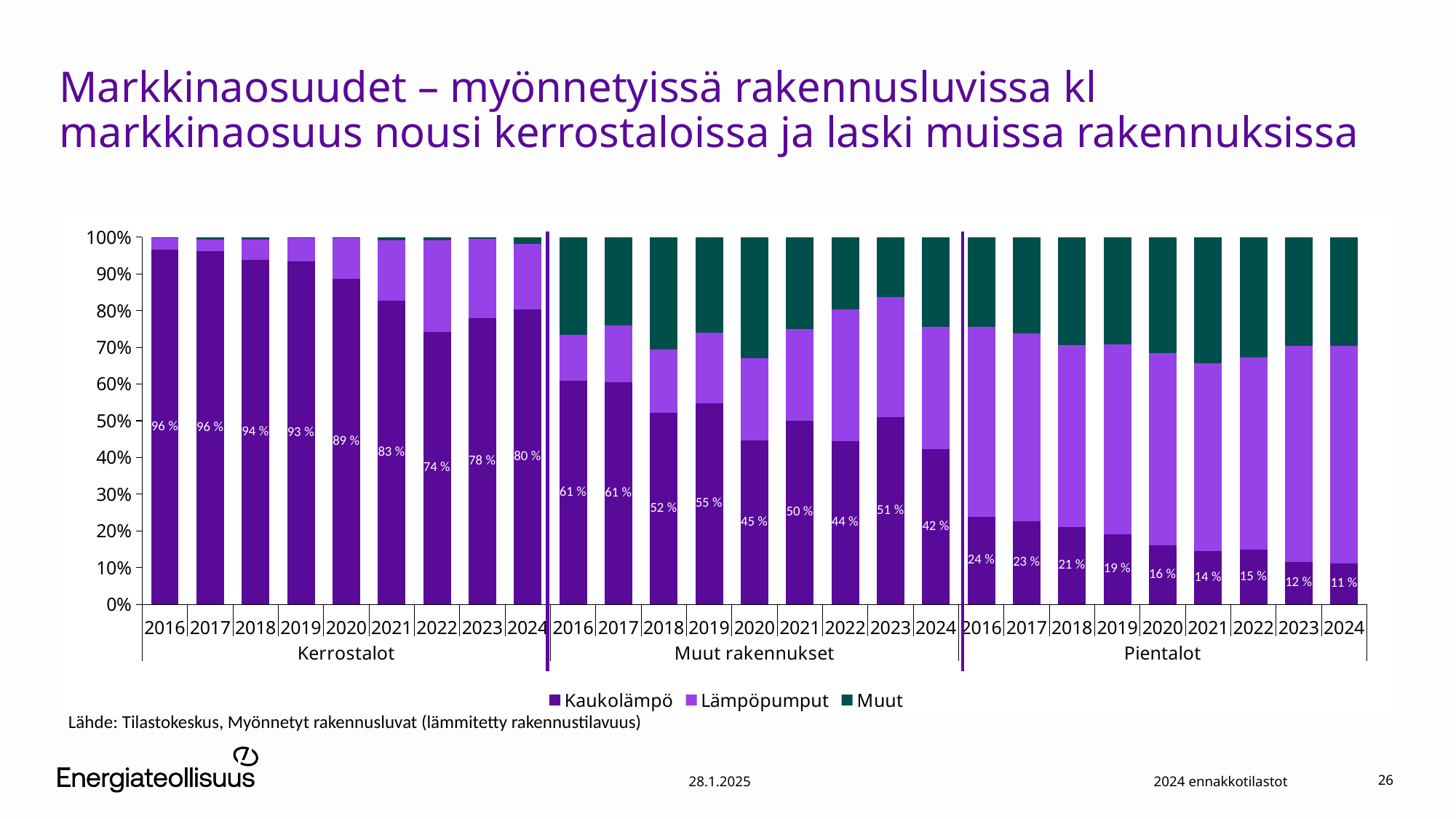
What is the Kaukolämpö share for Kerrostalot in 2024? 80 % What is the Kaukolämpö share for Pientalot in 2016? 24 % In which year is the Kaukolämpö share for Kerrostalot the lowest? 2022 What kind of chart is shown on the slide? Stacked bar chart For Muut rakennukset, which year has the larger Kaukolämpö share, 2019 or 2021? 2019 By how many percentage points did the Kaukolämpö share for Kerrostalot fall from 2016 to 2024? 16 percentage points How many building categories are shown on the x axis? 3 How many series does the legend list? 3 For Pientalot in 2021, is the combined share of Kaukolämpö and Lämpöpumput greater or less than 70%? less In which year is the Kaukolämpö share for Pientalot the highest? 2016 Does the Kaukolämpö share for Pientalot rise or fall from 2016 to 2024? Fall What is the Kaukolämpö share for Muut rakennukset in 2020? 45 %